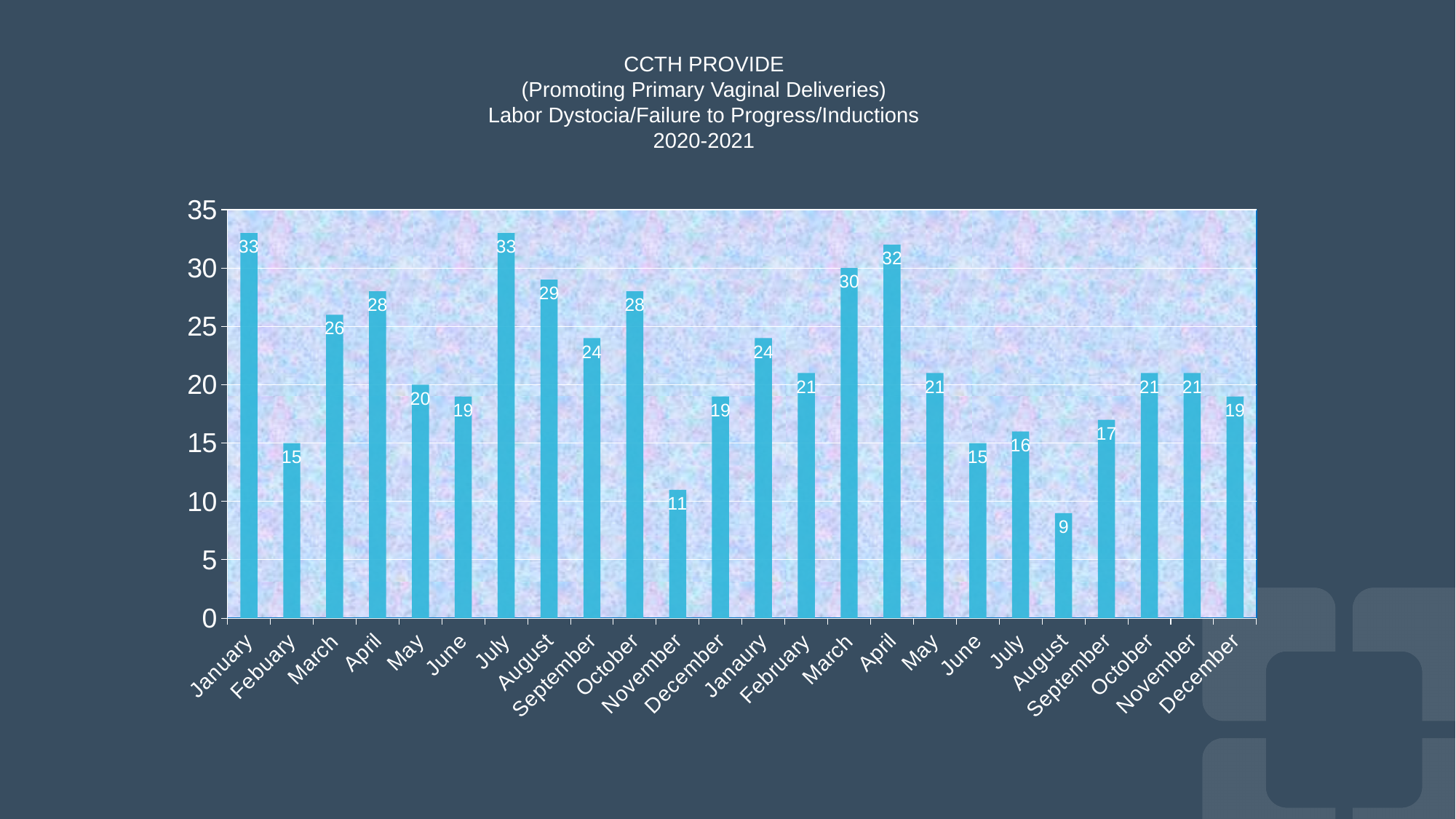
Which is larger: the first April bar or the second April bar? the second April (32) What type of chart is shown on the slide? bar chart What years does the chart title say the data covers? 2020-2021 What is the difference between the first October bar and the second October bar? 7 What is the value for the first January bar (leftmost bar)? 33 What is the value for the second December bar (rightmost bar)? 19 What is the value for the first November bar? 11 What is the value for the second March bar (the March in the right half of the chart)? 30 Is the value for the second September bar greater or less than 20? less Which month has the lowest value in the chart? the second August (9) What is the difference between the first July bar (33) and the second August bar (9)? 24 How many bars (months) are plotted in the chart? 24